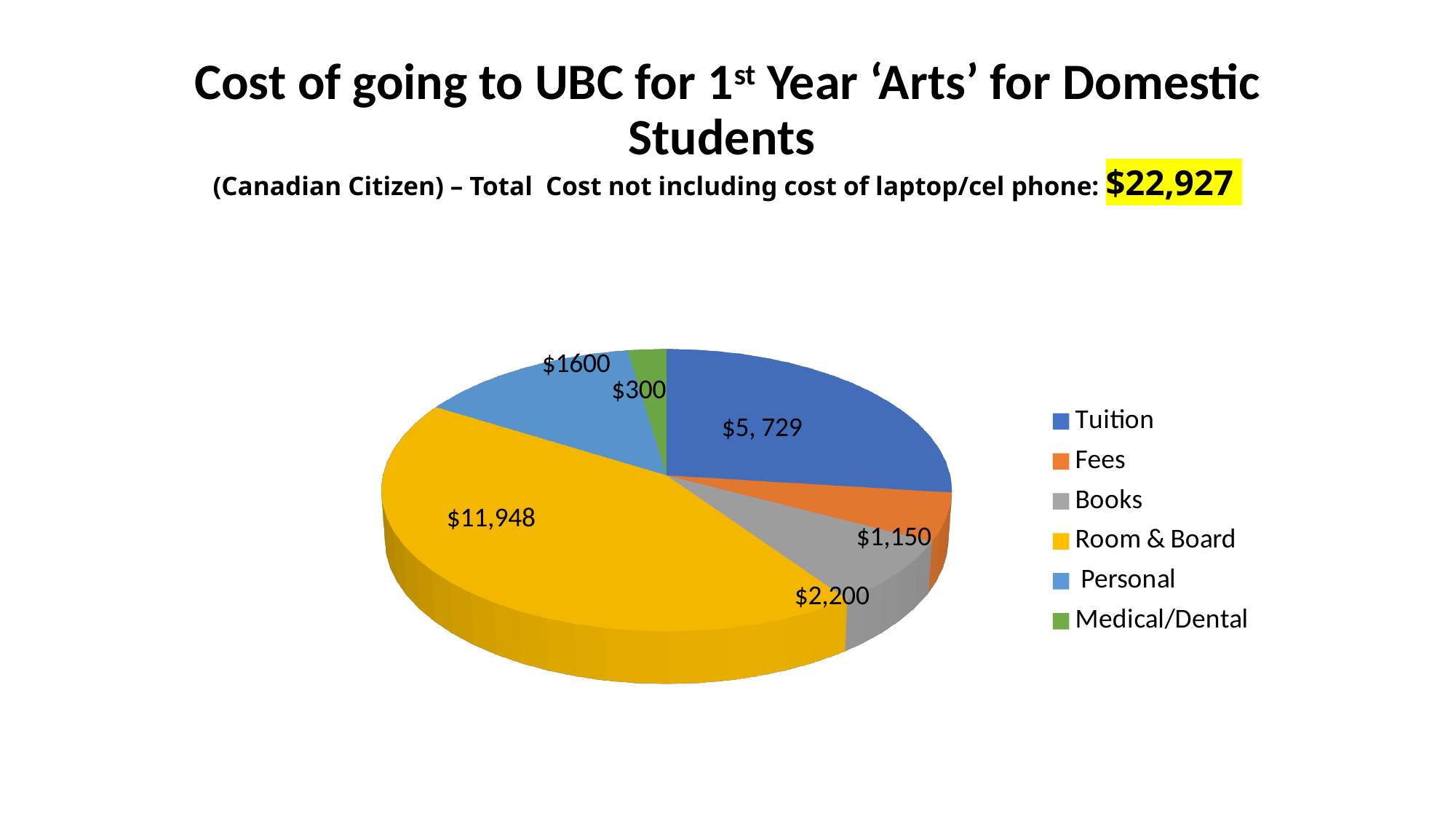
What is the cost of Tuition shown in the pie chart? $5,729 How many categories does the pie chart legend list? 6 Which is larger, the Personal cost or the Fees cost? Personal What is the cost of Medical/Dental shown in the pie chart? $300 What type of chart is shown on the slide? pie chart What is the difference between the Books cost and the Fees cost? $1,050 How much more does Room & Board cost than Tuition? $6,219 What colour is the Room & Board slice in the pie chart? yellow Which category has the largest slice of the pie chart? Room & Board What is the cost of Books shown in the pie chart? $2,200 What is the cost of Room & Board shown in the pie chart? $11,948 Which category has the smallest slice of the pie chart? Medical/Dental